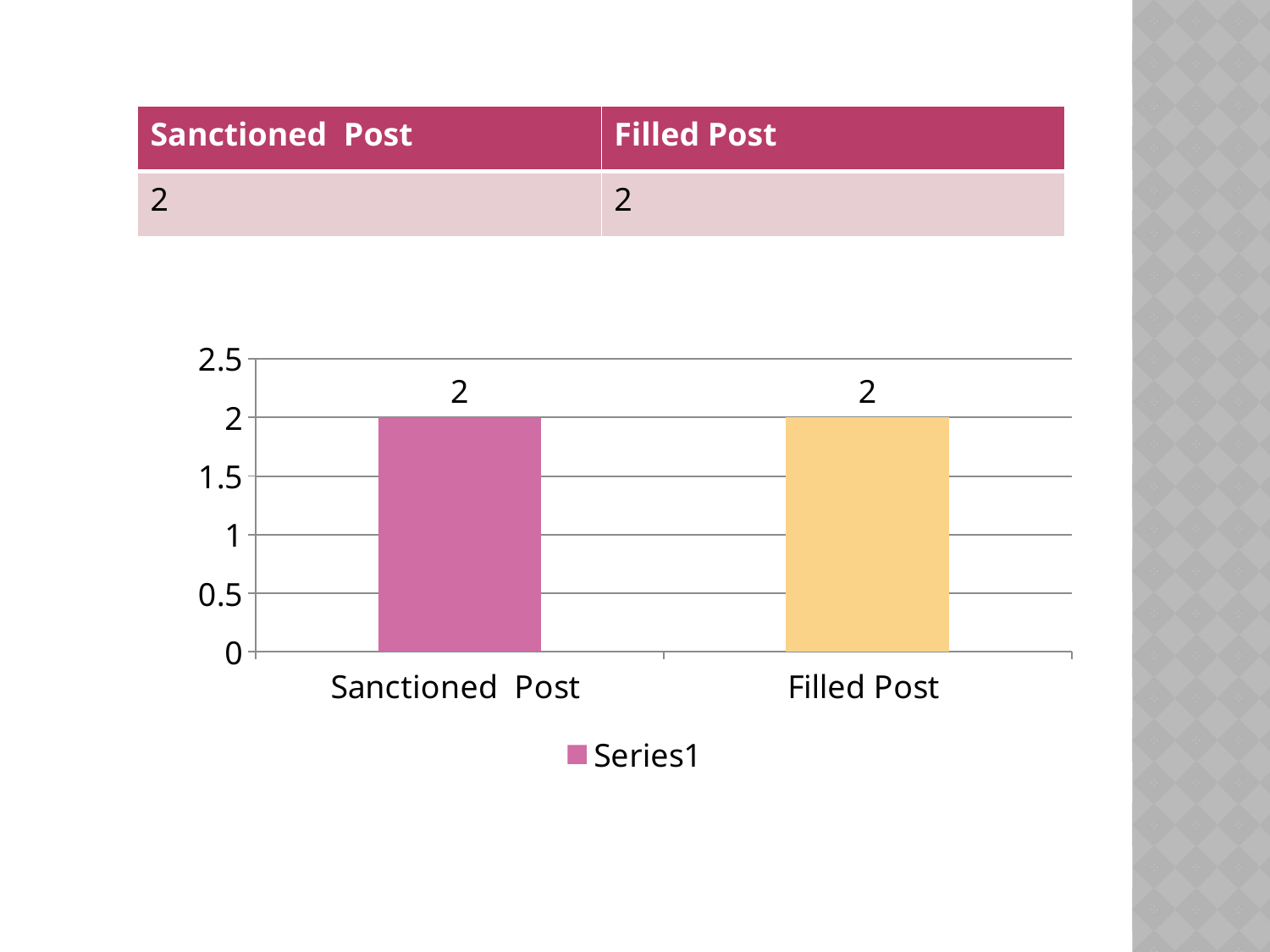
What is the value for Filled Post? 2 What is the highest value shown on the y axis of the chart? 2.5 Is the value for Filled Post greater or less than 2.5? less Is the value for Sanctioned Post greater or less than 1.5? greater What is the name of the series listed in the legend? Series1 What is the value for Sanctioned Post? 2 How many series does the legend list? 1 What is the difference between the values for Sanctioned Post and Filled Post? 0 Do the values rise, fall or stay the same from Sanctioned Post to Filled Post? stay the same How many categories are shown on the x axis of the chart? 2 What kind of chart is shown on the slide? bar chart